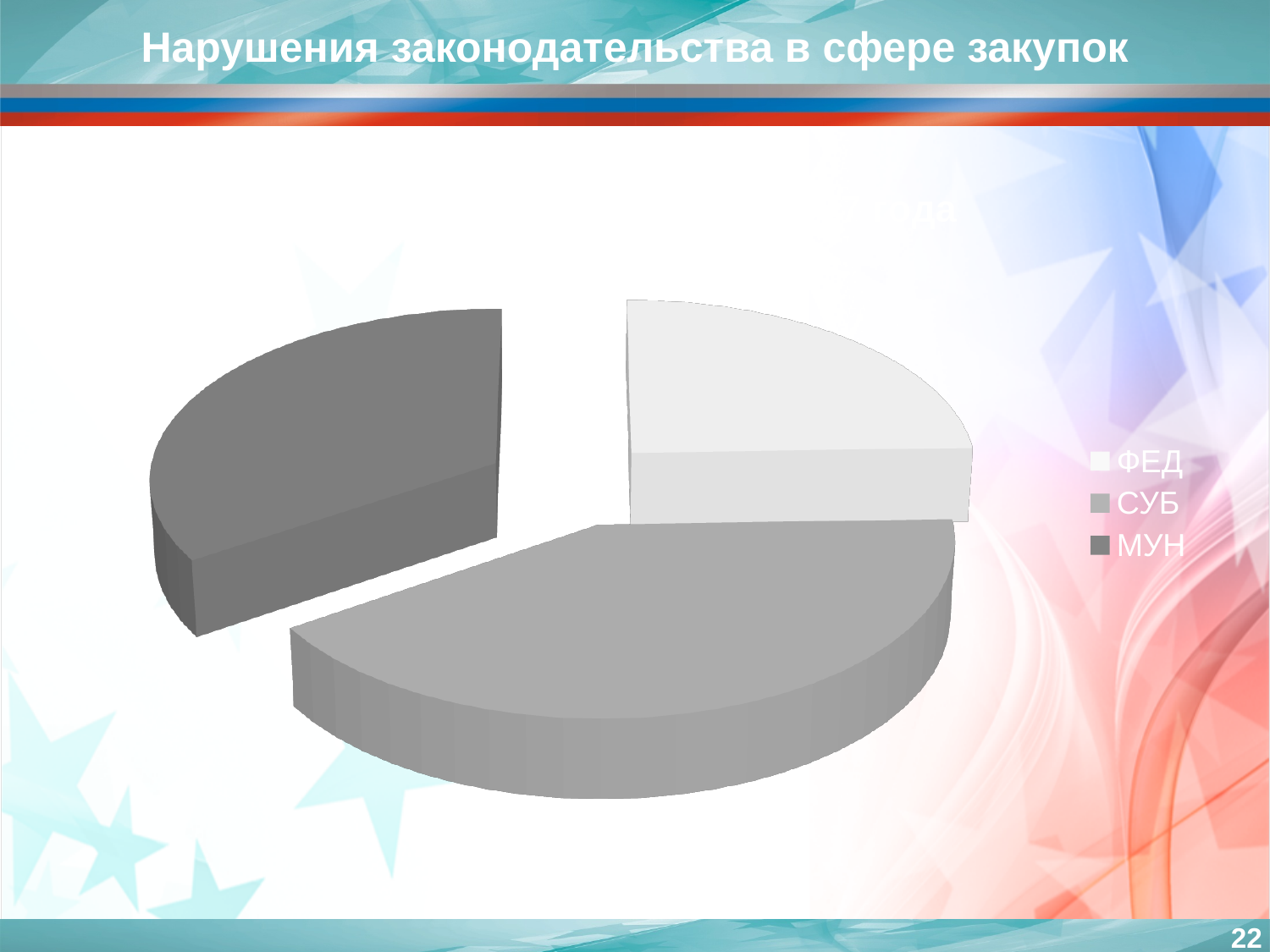
How many slices does the pie chart have? 3 Which slice is larger, СУБ or ФЕД? СУБ How many entries does the legend of the pie chart list? 3 What kind of chart is shown on the slide? pie chart Which slice is larger, СУБ or МУН? СУБ Which category has the largest slice in the pie chart? СУБ Which legend category is shown with the lightest (white) slice? ФЕД What are the legend entries of the pie chart, from top to bottom? ФЕД, СУБ, МУН